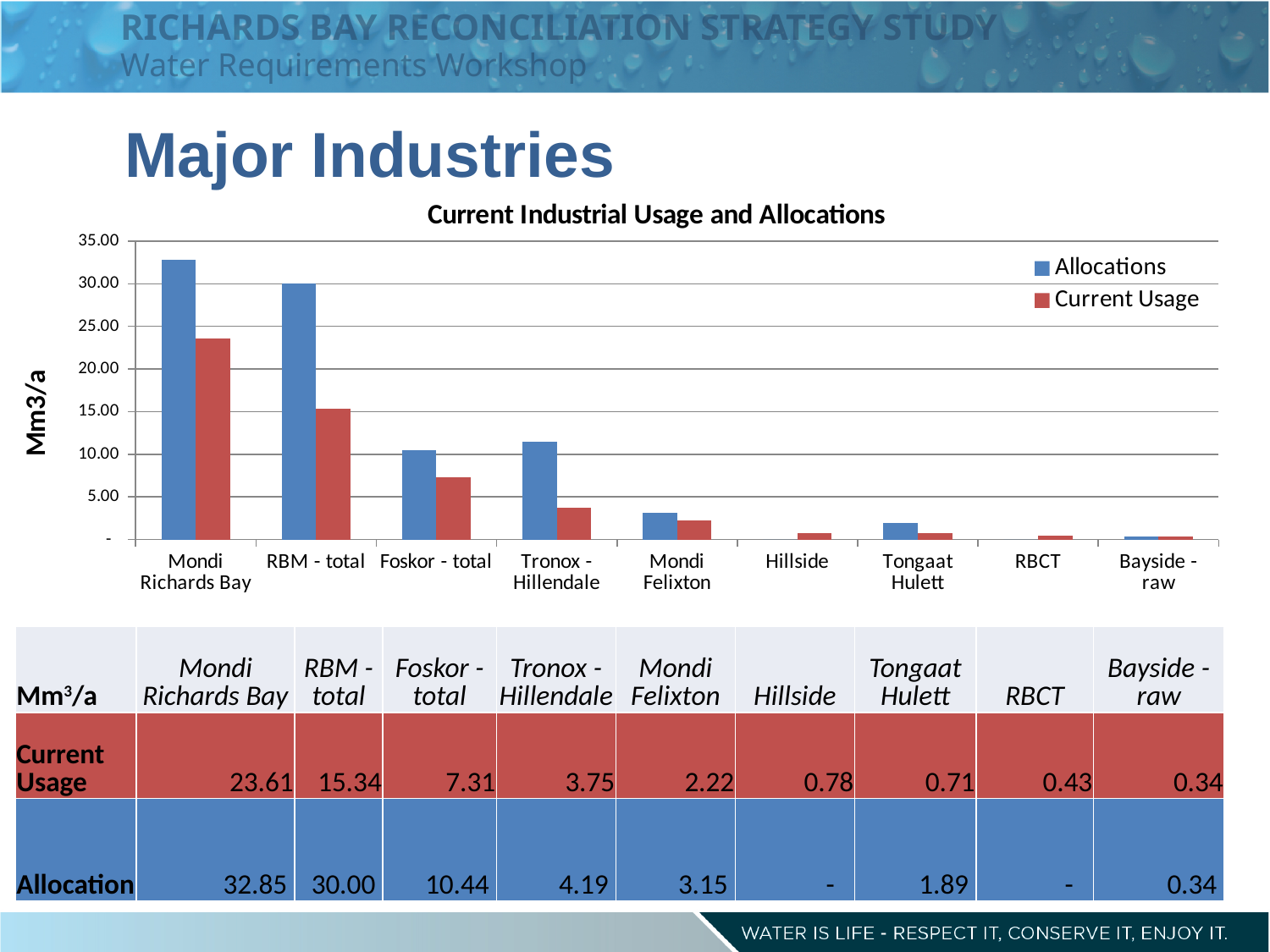
Is the Allocations value for RBM - total greater or less than 25.00? greater Which industry has the highest Current Usage value? Mondi Richards Bay What is the difference between the Allocation and Current Usage for Mondi Richards Bay? 9.24 How many series does the chart legend list? 2 How many industries are shown on the x axis of the chart? 9 What kind of chart is shown on the slide? bar chart Which is larger for Tronox - Hillendale, the Allocation or the Current Usage? Allocation What is the Allocation value for Foskor - total? 10.44 What is the Current Usage value for RBM - total? 15.34 What is the unit shown on the y axis of the chart? Mm3/a What is the title of the chart? Current Industrial Usage and Allocations Which industry has the highest Allocations value? Mondi Richards Bay